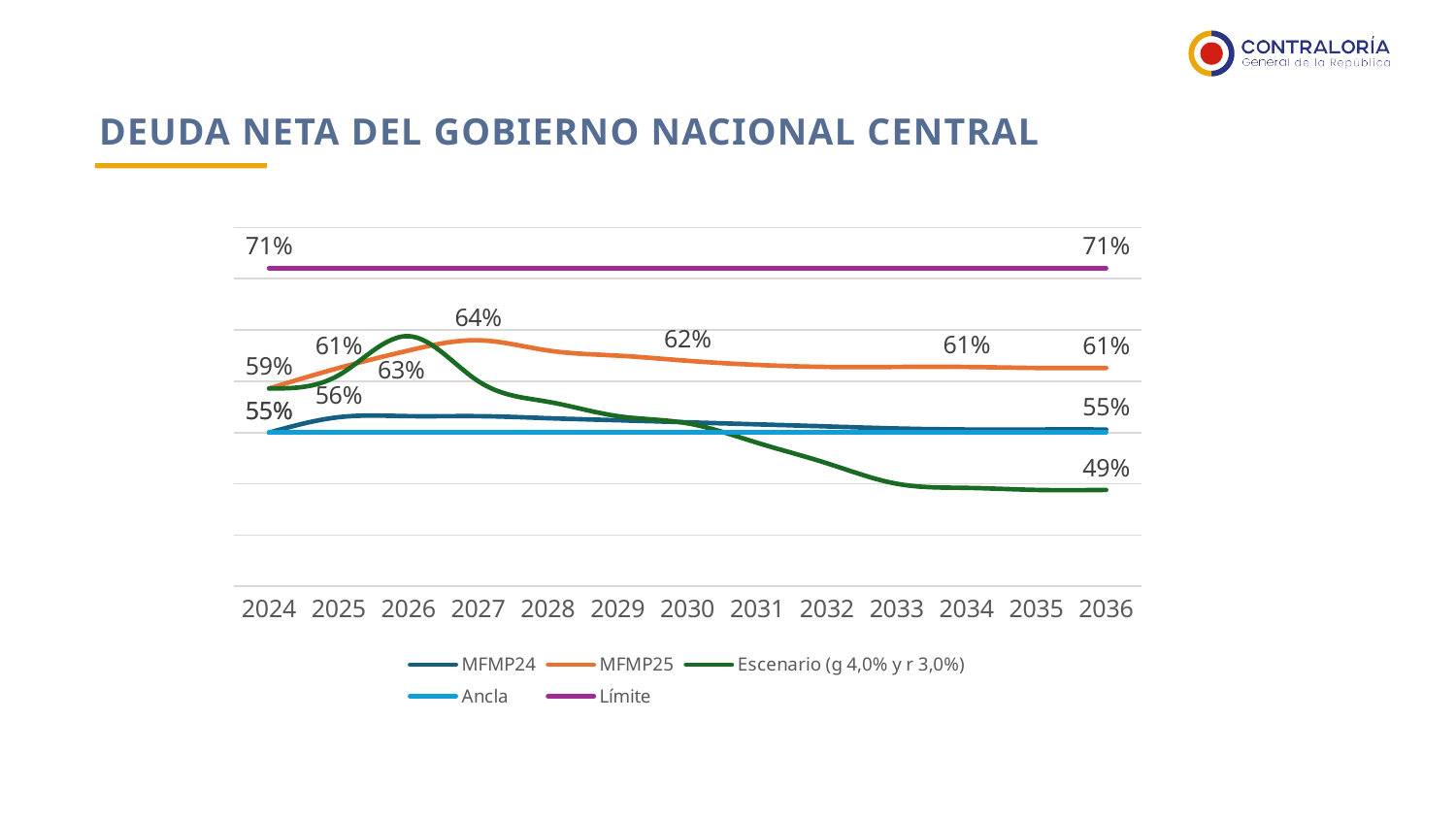
How many series does the legend list? 5 What is the difference between the Límite value and the MFMP25 value in 2036? 10 percentage points What is the value of the MFMP25 line in 2036? 61% What is the value of the MFMP24 line in 2036? 55% How many years are shown on the x axis? 13 Does the Escenario (g 4,0% y r 3,0%) line rise or fall between 2027 and 2036? Fall Which series has the highest value across the whole chart? Límite What is the value of the Escenario (g 4,0% y r 3,0%) line in 2036? 49% What kind of chart is shown on the slide? Line chart Which series has the lowest value in 2036? Escenario (g 4,0% y r 3,0%) What is the peak value labelled on the MFMP25 line, reached in 2027? 64% What is the value of the Límite line in 2036? 71%